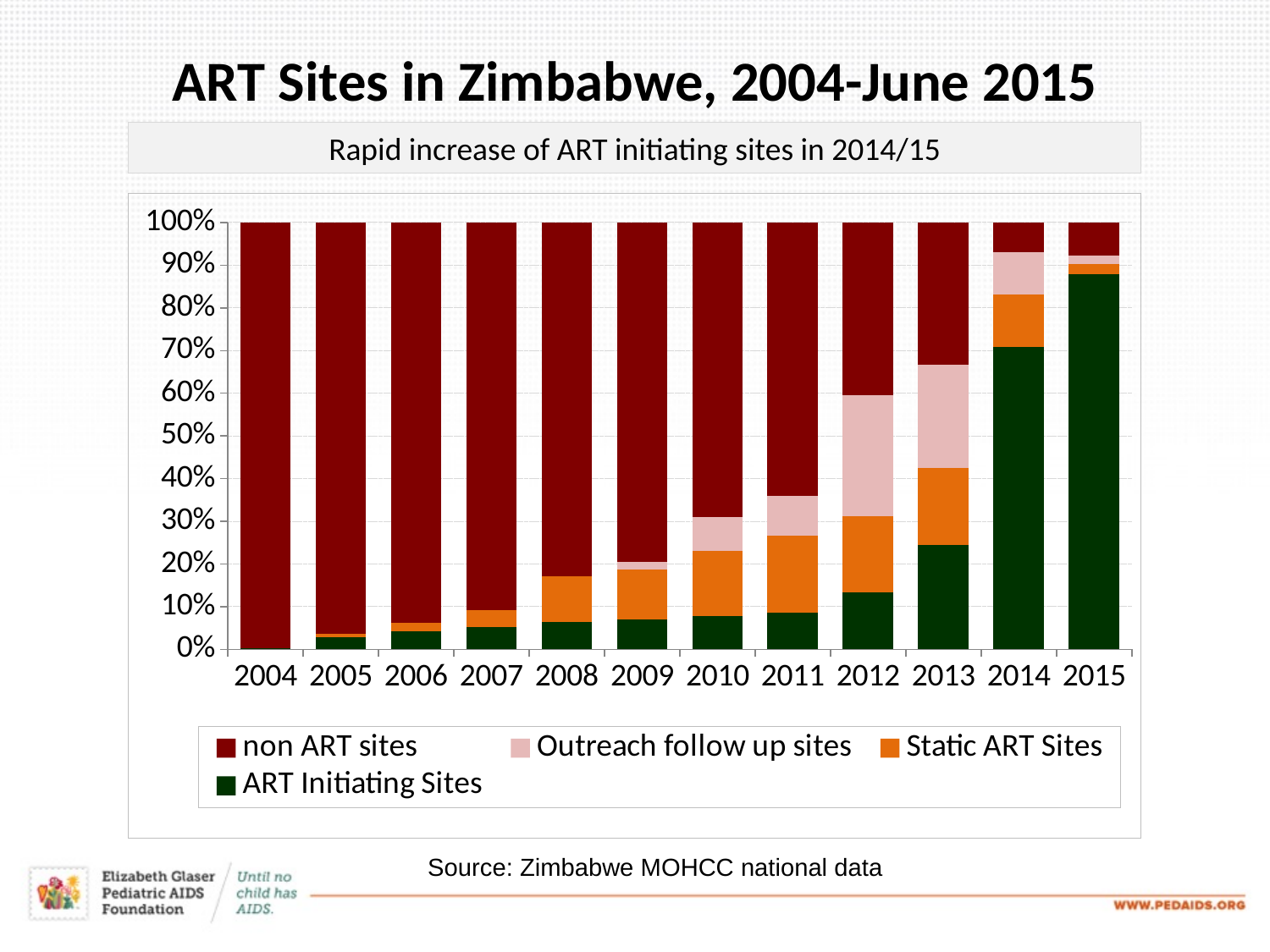
Is the share of ART Initiating Sites in 2015 greater or less than 80%? greater Which year has the smallest share of ART Initiating Sites? 2004 How many series does the legend list? 4 What is the subtitle shown above the chart? Rapid increase of ART initiating sites in 2014/15 Is the share of ART Initiating Sites in 2014 greater or less than 60%? greater Which year has a larger share of ART Initiating Sites, 2013 or 2014? 2014 Is the share of non ART sites in 2012 greater or less than 30%? greater How many years are shown along the x axis? 12 What kind of chart is shown on the slide? Stacked bar chart Which year has the largest share of ART Initiating Sites? 2015 Does the share of ART Initiating Sites rise or fall from 2004 to 2015? Rise